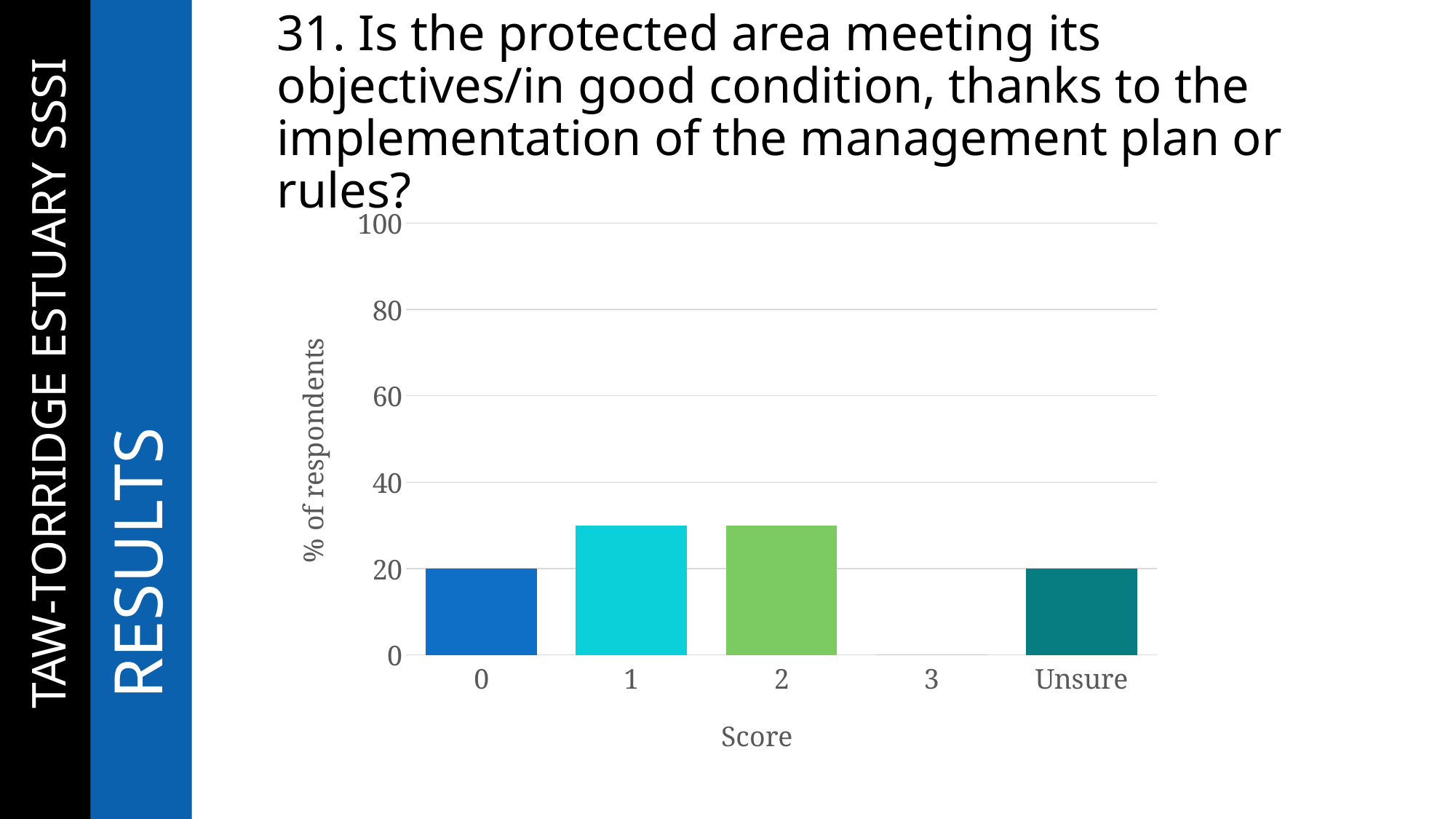
Which has a larger % of respondents, score 1 or score 0? score 1 What is the % of respondents for Unsure? 20 What is the % of respondents for score 0? 20 Is the value for score 1 greater or less than 20? greater How many score categories are shown on the x axis? 5 What is the % of respondents for score 3? 0 Is the value for score 2 greater or less than 40? less What is the label of the x axis? Score Which score category has the lowest % of respondents? 3 What is the difference in % of respondents between score 0 and score 3? 20 What is the label of the y axis? % of respondents What type of chart is shown on the slide? bar chart